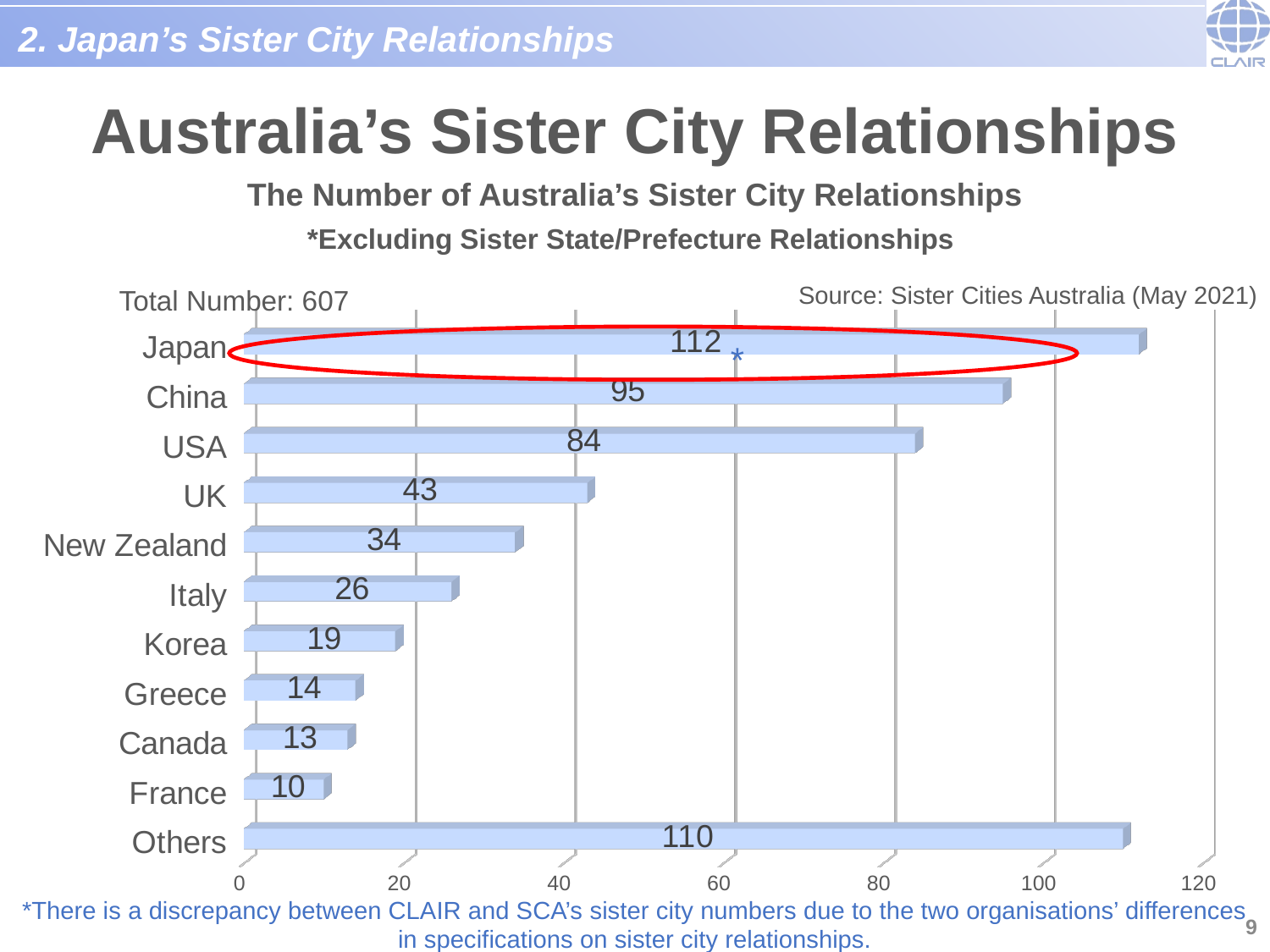
What is the number of sister city relationships for Japan? 112 What is the value shown for Greece? 14 What is the value shown for New Zealand? 34 What is the difference between the values for Japan and Others? 2 Which named country (excluding Others) has the highest number of sister city relationships? Japan Is the value for Italy greater or less than 20? greater What kind of chart is shown on the slide? Bar chart What is the difference between the values for China and USA? 11 Which has a larger value, UK or New Zealand? UK What total number is stated above the chart? 607 Which category has the lowest value on the chart? France How many categories are shown on the chart? 11